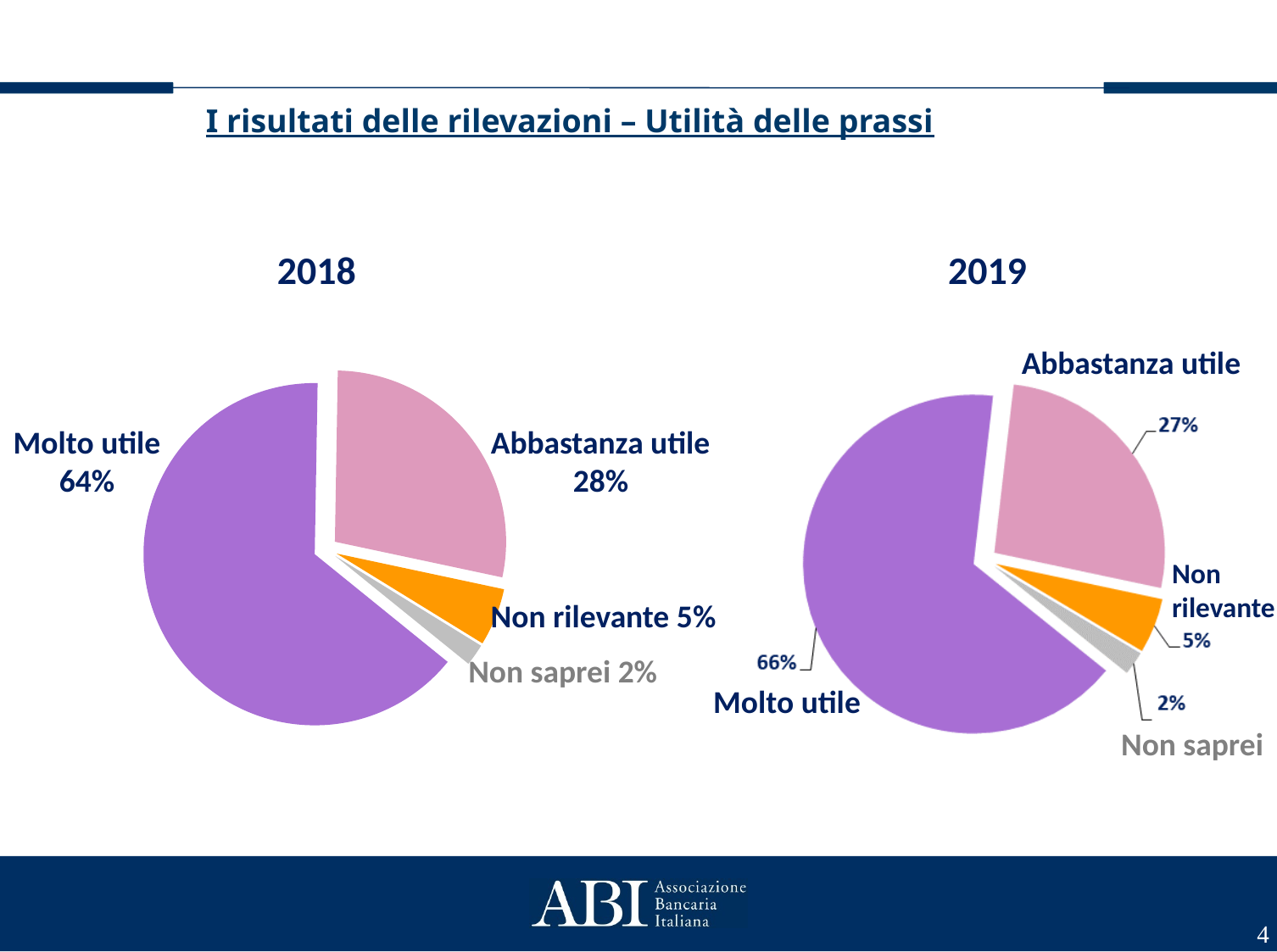
What colour is the "Non rilevante" slice in the 2018 pie chart? Orange What is the difference between the "Molto utile" share in 2019 and in 2018? 2% In the 2019 pie chart, which category has the largest slice? Molto utile In the 2019 pie chart, what is the value for "Non saprei"? 2% In the 2018 pie chart, what share does "Molto utile" have? 64% In the 2018 pie chart, what is the difference between "Abbastanza utile" and "Non rilevante"? 23% In the 2018 pie chart, which category has the smallest slice? Non saprei Which is larger: "Abbastanza utile" in 2018 or "Abbastanza utile" in 2019? 2018 How many categories does the 2019 pie chart show? 4 In the 2019 pie chart, what share does "Abbastanza utile" have? 27% In the 2018 pie chart, what is the value for "Non rilevante"? 5% What type of chart is used for the 2018 data? Pie chart